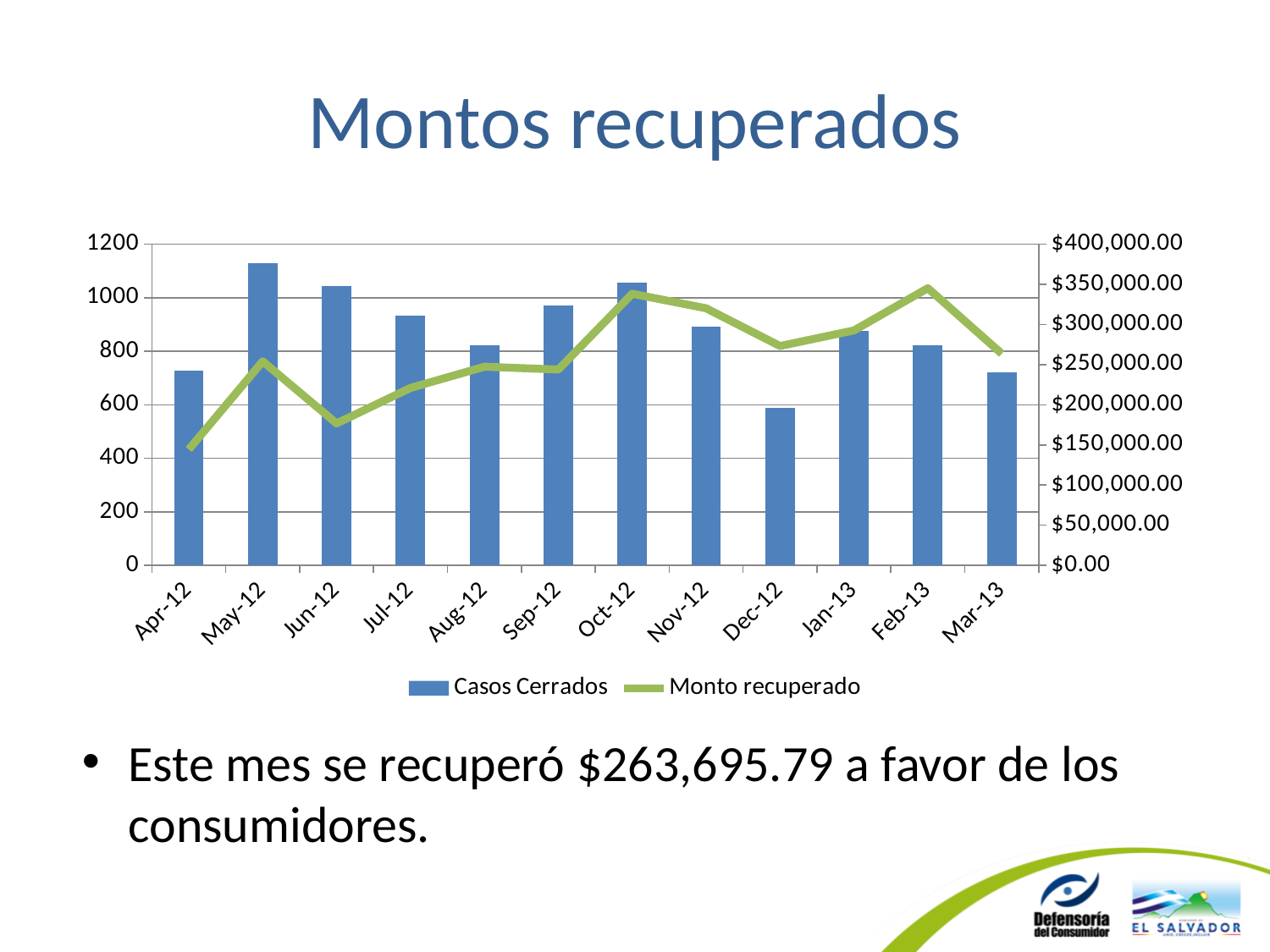
Is the Casos Cerrados value for Dec-12 greater or less than 800? less Which month has the lowest value for Casos Cerrados? Dec-12 Which month has more Casos Cerrados, Jun-12 or Jul-12? Jun-12 Which month has the highest value for Casos Cerrados? May-12 How many months are shown on the x axis of the chart? 12 Does the Monto recuperado line rise or fall from Dec-12 to Feb-13? rise What kind of chart is shown on the slide? A combined bar and line chart Which month has the lowest value for Monto recuperado? Apr-12 Is the Casos Cerrados value for May-12 greater or less than 1000? greater What is the title of the chart slide? Montos recuperados How many series does the chart legend list? 2 Is the Monto recuperado value for Oct-12 greater or less than $300,000.00? greater